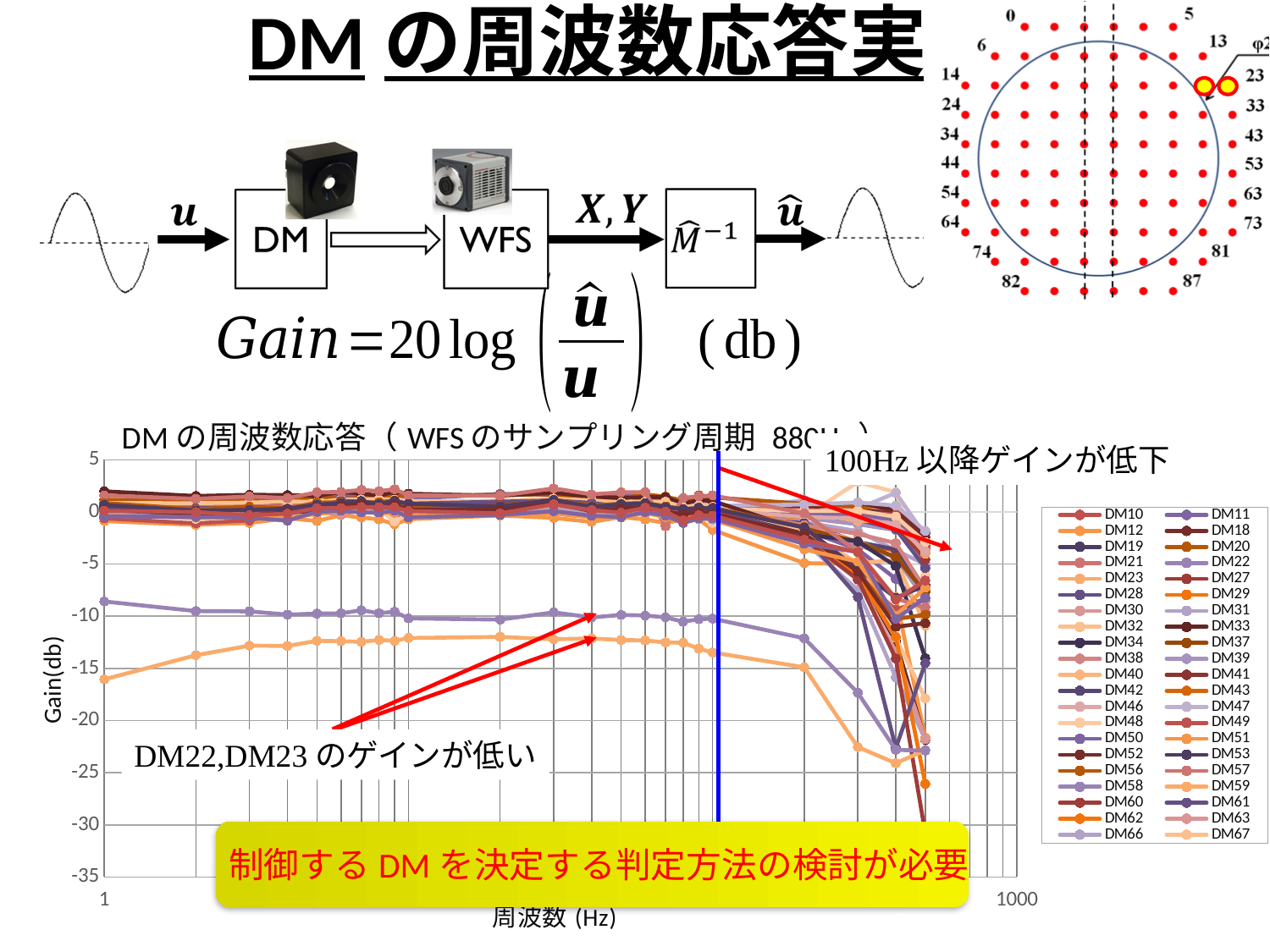
What is the label of the vertical axis of the chart? Gain(db) What kind of chart is shown on the slide? line chart Is the gain for DM22 at 1 Hz greater or less than -5? less What is the lowest tick value shown on the vertical axis of the chart? -35 Do the gain values of the series rise or fall as the frequency increases beyond 100 Hz? fall How many series does the chart's legend list? 42 What is the label of the horizontal axis of the chart? 周波数 (Hz) Is the gain for DM22 at 10 Hz greater or less than -15? greater Is the gain for DM23 at 1 Hz greater or less than -10? less